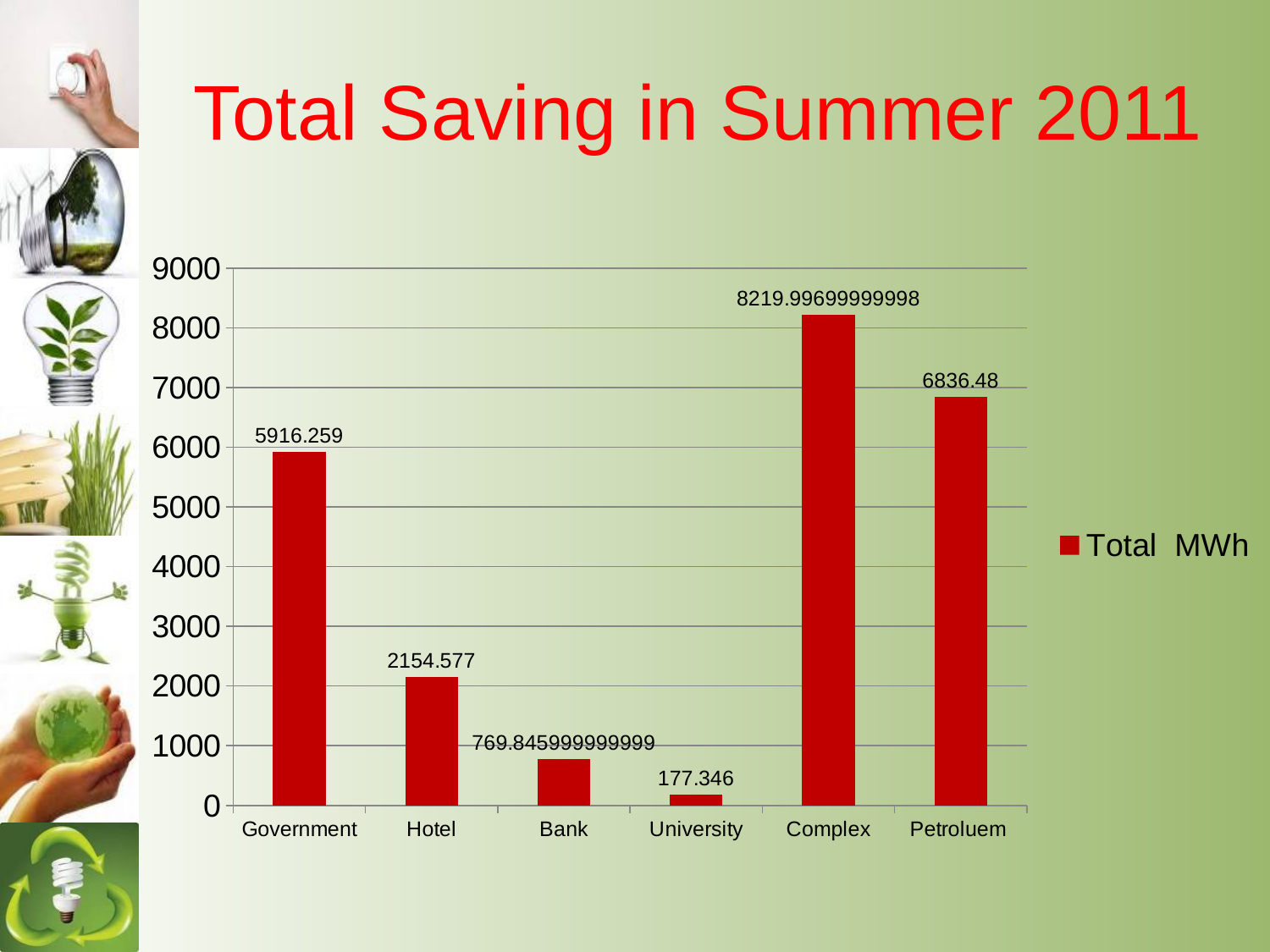
How many categories are shown on the x axis? 6 What is the value for Government? 5916.259 What is the difference between the values for Petroluem and Government? 920.221 Is the value for Complex greater or less than 8000? greater What is the value for Petroluem? 6836.48 Which is larger, the value for Bank or the value for Hotel? Hotel Which category has the highest value? Complex What kind of chart is shown on the slide? Bar chart What is the value for University? 177.346 What is the value for Hotel? 2154.577 Which category has the lowest value? University What is the difference between the values for Government and Hotel? 3761.682